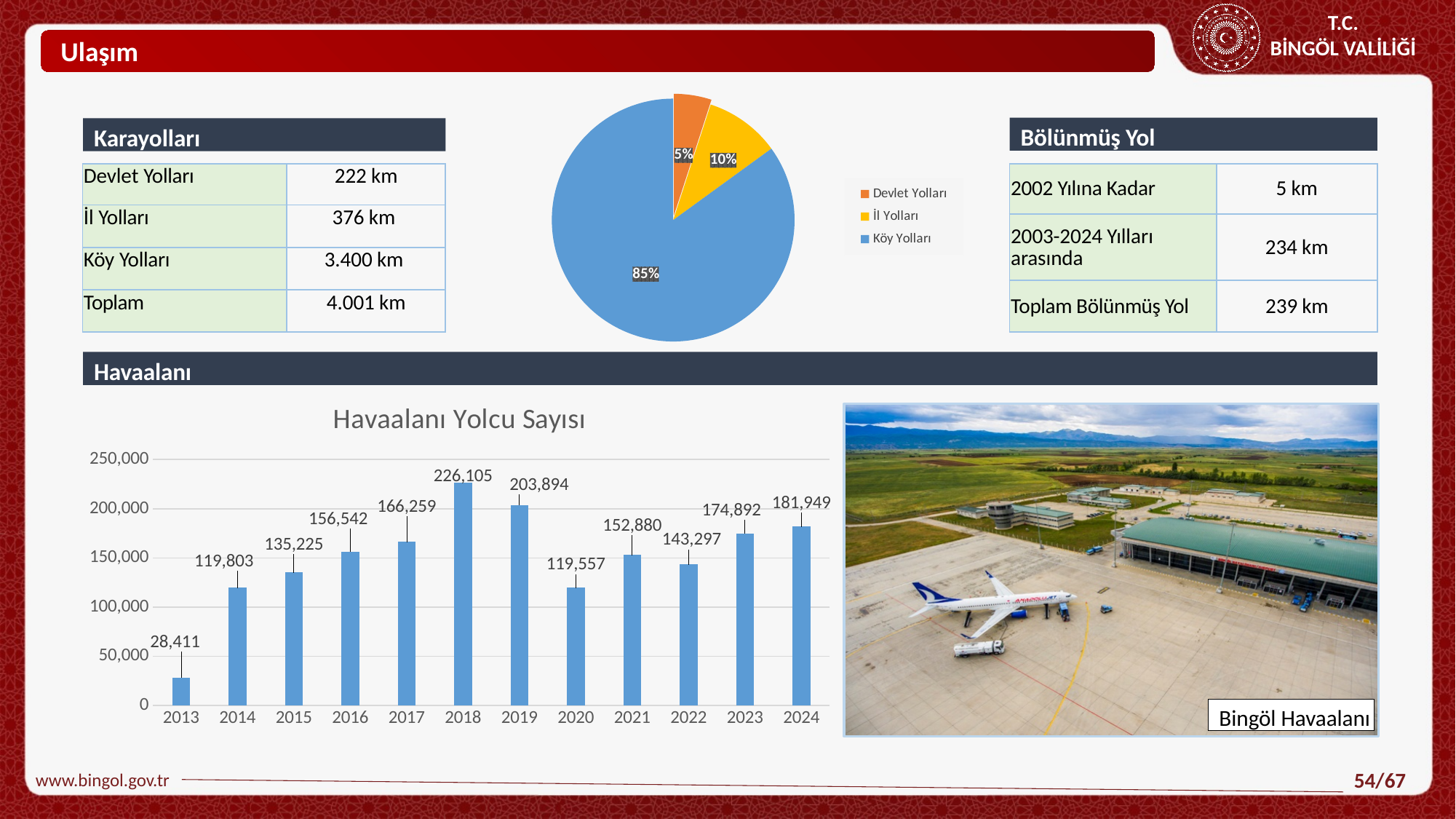
In the 'Havaalanı Yolcu Sayısı' bar chart, what is the value for 2018? 226,105 In the 'Havaalanı Yolcu Sayısı' bar chart, what is the difference between the values for 2019 and 2020? 84,337 What kind of chart is 'Havaalanı Yolcu Sayısı'? bar chart How many entries does the legend of the pie chart at the top of the slide list? 3 In the 'Havaalanı Yolcu Sayısı' bar chart, which year has the highest value? 2018 In the 'Havaalanı Yolcu Sayısı' bar chart, what is the value for 2024? 181,949 In the pie chart at the top of the slide, what share does İl Yolları have? 10% In the 'Havaalanı Yolcu Sayısı' bar chart, which year has the lowest value? 2013 In the 'Havaalanı Yolcu Sayısı' bar chart, which is larger, the value for 2021 or the value for 2022? 2021 In the pie chart at the top of the slide, what share does Köy Yolları have? 85% In the 'Havaalanı Yolcu Sayısı' bar chart, how many years are shown on the x axis? 12 In the 'Havaalanı Yolcu Sayısı' bar chart, do the values rise or fall from 2013 to 2018? rise